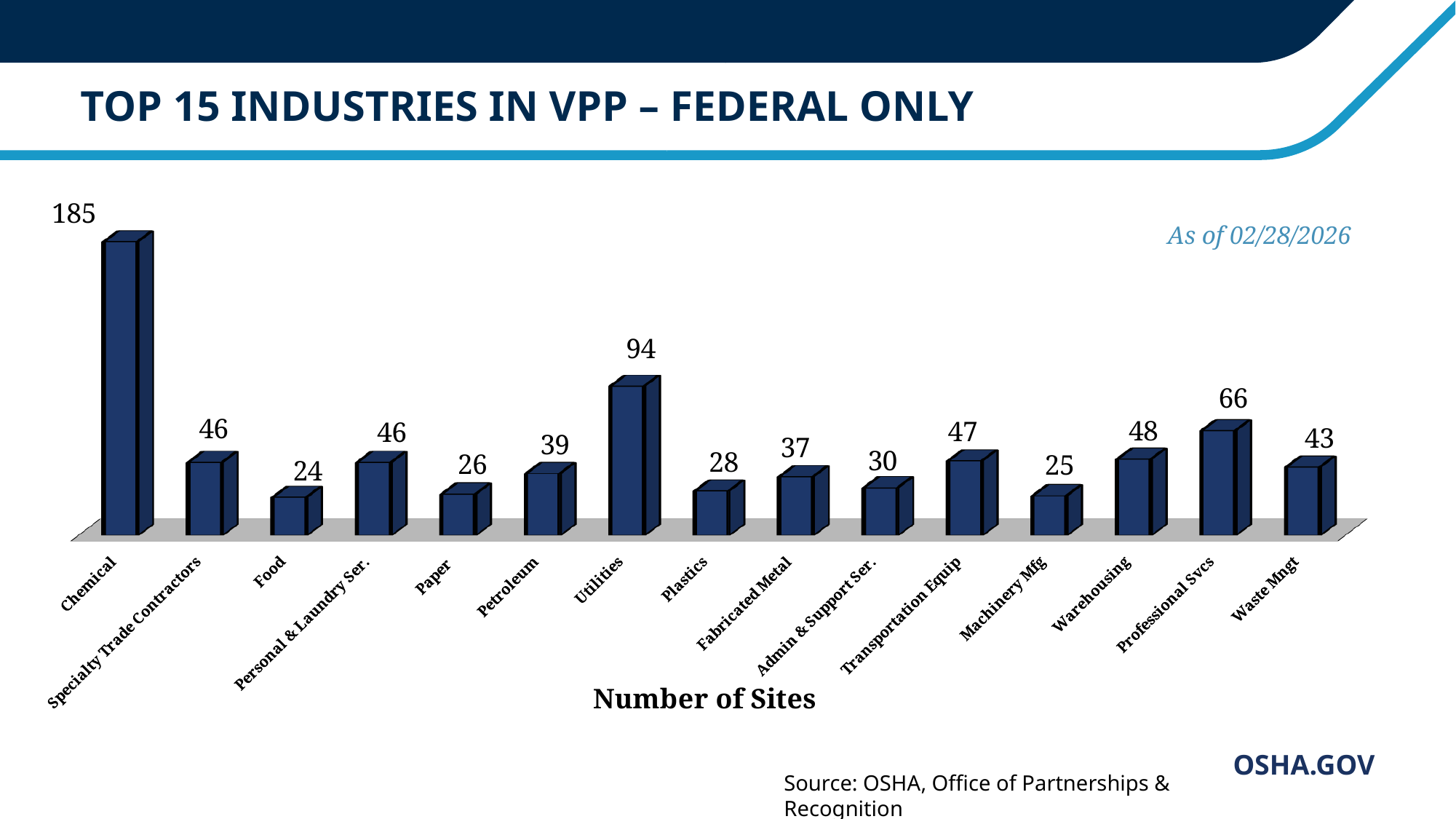
What is the value shown for Professional Svcs? 66 Which has more sites, Plastics or Fabricated Metal? Fabricated Metal What type of chart is shown on the slide? Bar chart Which has more sites, Petroleum or Waste Mngt? Waste Mngt What is the 'as of' date shown on the slide? 02/28/2026 What is the difference in number of sites between Chemical and Utilities? 91 How many industries are shown in the chart? 15 What is the difference between Warehousing and Machinery Mfg? 23 Which industry has the highest number of sites? Chemical What is the number of sites for Utilities? 94 How many sites does the Chemical industry have? 185 Which industry has the lowest number of sites? Food